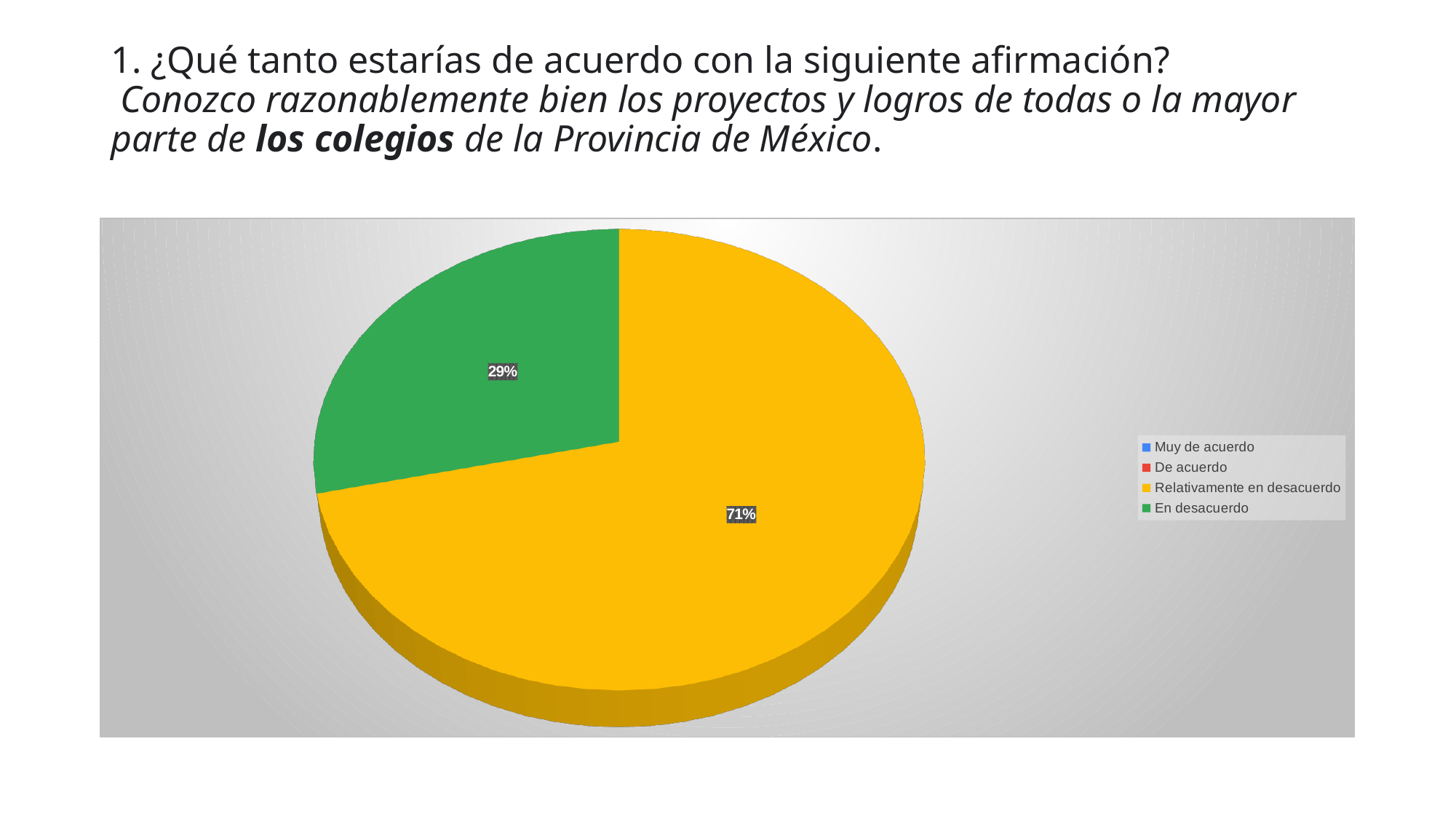
What colour is the "En desacuerdo" slice? green What share of the pie does "En desacuerdo" represent? 29% Is the share for "Relativamente en desacuerdo" greater or less than 50%? greater How many entries does the legend list? 4 What colour does the legend assign to "Relativamente en desacuerdo"? yellow Is the share for "En desacuerdo" greater or less than 50%? less How many slices are visible in the pie? 2 Which of the visible slices is smaller, "Relativamente en desacuerdo" or "En desacuerdo"? En desacuerdo What share of the pie does "Relativamente en desacuerdo" represent? 71% Which category has the largest slice of the pie? Relativamente en desacuerdo What kind of chart is shown on the slide? pie chart What is the difference in percentage points between the "Relativamente en desacuerdo" slice and the "En desacuerdo" slice? 42%